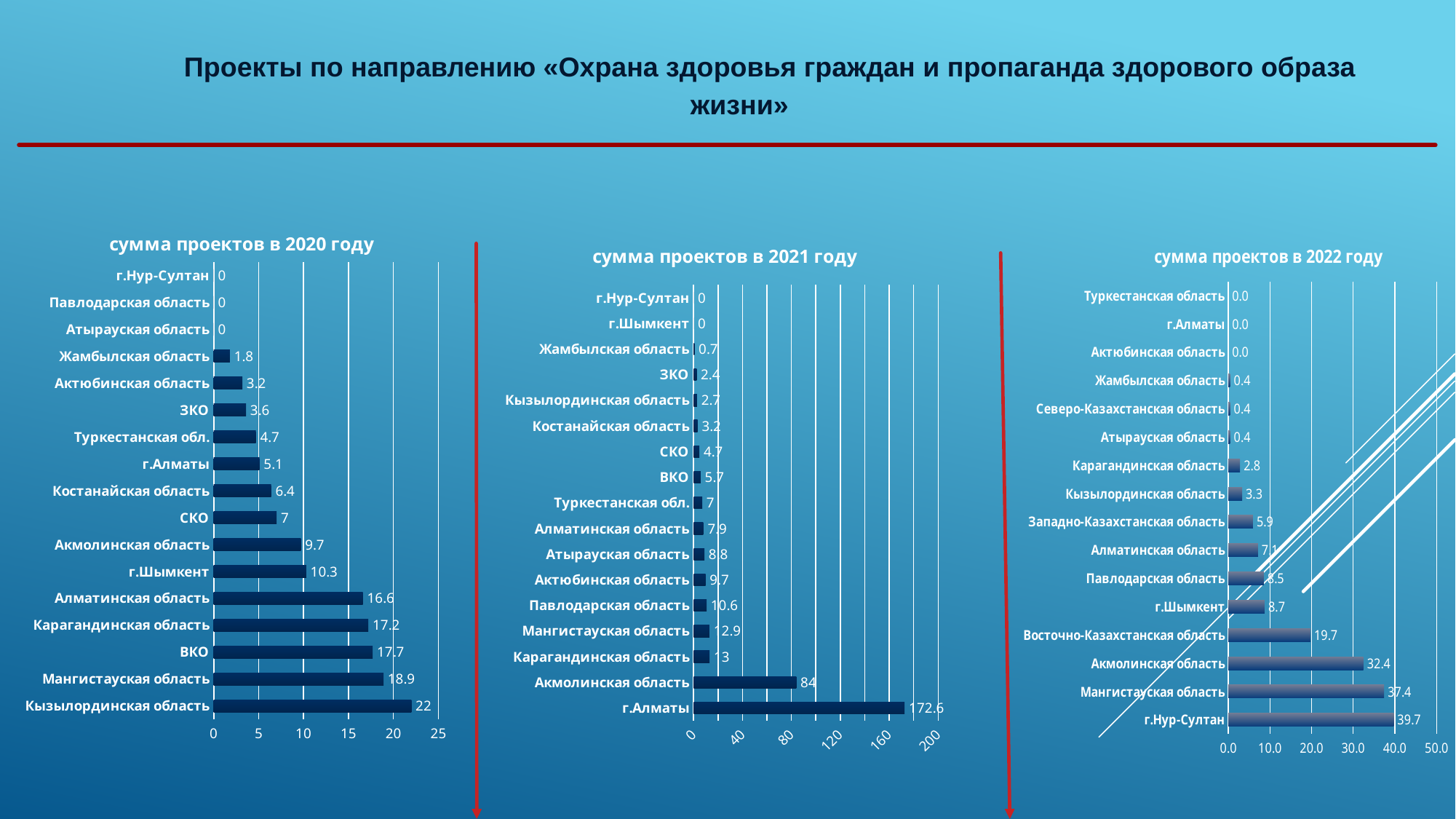
In the chart 'сумма проектов в 2022 году', what is the value for г.Нур-Султан? 39.7 What type of chart is 'сумма проектов в 2022 году'? Bar chart In the chart 'сумма проектов в 2021 году', what is the value for Павлодарская область? 10.6 In the chart 'сумма проектов в 2021 году', is the value for Акмолинская область greater or less than 80? greater In the chart 'сумма проектов в 2020 году', what is the value for Кызылординская область? 22 In the chart 'сумма проектов в 2020 году', which category has the highest value? Кызылординская область In the chart 'сумма проектов в 2020 году', what is the difference between Мангистауская область and ВКО? 1.2 In the chart 'сумма проектов в 2022 году', which category has the highest value? г.Нур-Султан In the chart 'сумма проектов в 2022 году', what is the difference between Мангистауская область and Акмолинская область? 5.0 In the chart 'сумма проектов в 2021 году', which is larger, Акмолинская область or Карагандинская область? Акмолинская область In the chart 'сумма проектов в 2020 году', how many categories are shown? 17 In the chart 'сумма проектов в 2021 году', what is the value for г.Алматы? 172.6